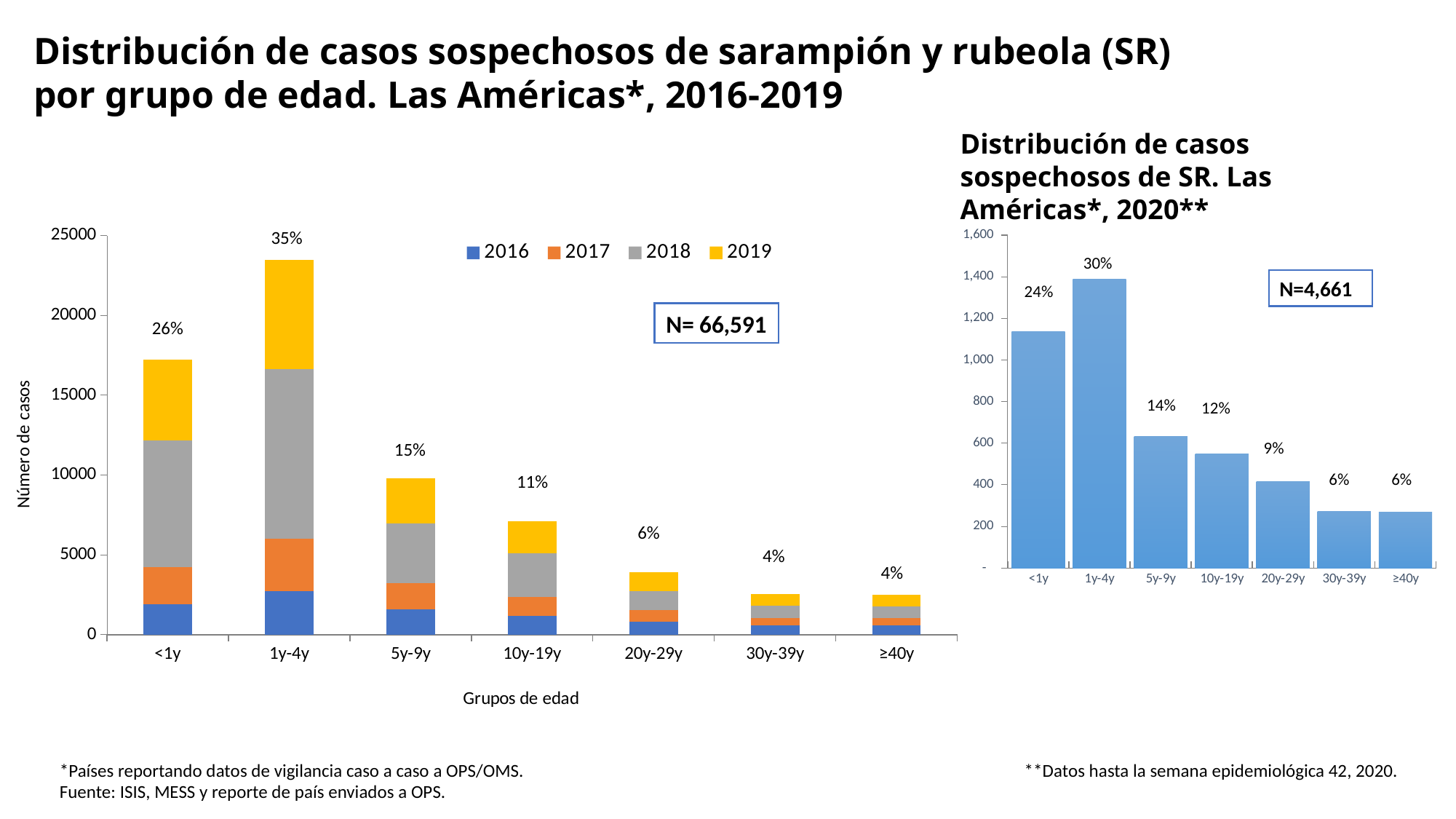
In the left chart (2016-2019), what percentage label is shown for the <1y age group? 26% In the right chart (2020), how many age groups are shown on the x axis? 7 What is the N value shown in the box on the right chart (2020)? N=4,661 In the right chart (2020), what percentage label is shown for the 20y-29y age group? 9% What kind of chart is the left chart (2016-2019)? Stacked bar chart In the left chart (2016-2019), what percentage label is shown for the 1y-4y age group? 35% In the right chart (2020), which age group has the highest bar? 1y-4y In the right chart (2020), which is larger, the percentage for 5y-9y or for 10y-19y? 5y-9y In the right chart (2020), is the value for the 5y-9y age group greater or less than 800? less In the left chart (2016-2019), is the total stacked value for the 1y-4y age group greater or less than 20000? greater In the left chart (2016-2019), how many series does the legend list? 4 In the left chart (2016-2019), what is the difference in percentage points between the 1y-4y label (35%) and the <1y label (26%)? 9 percentage points